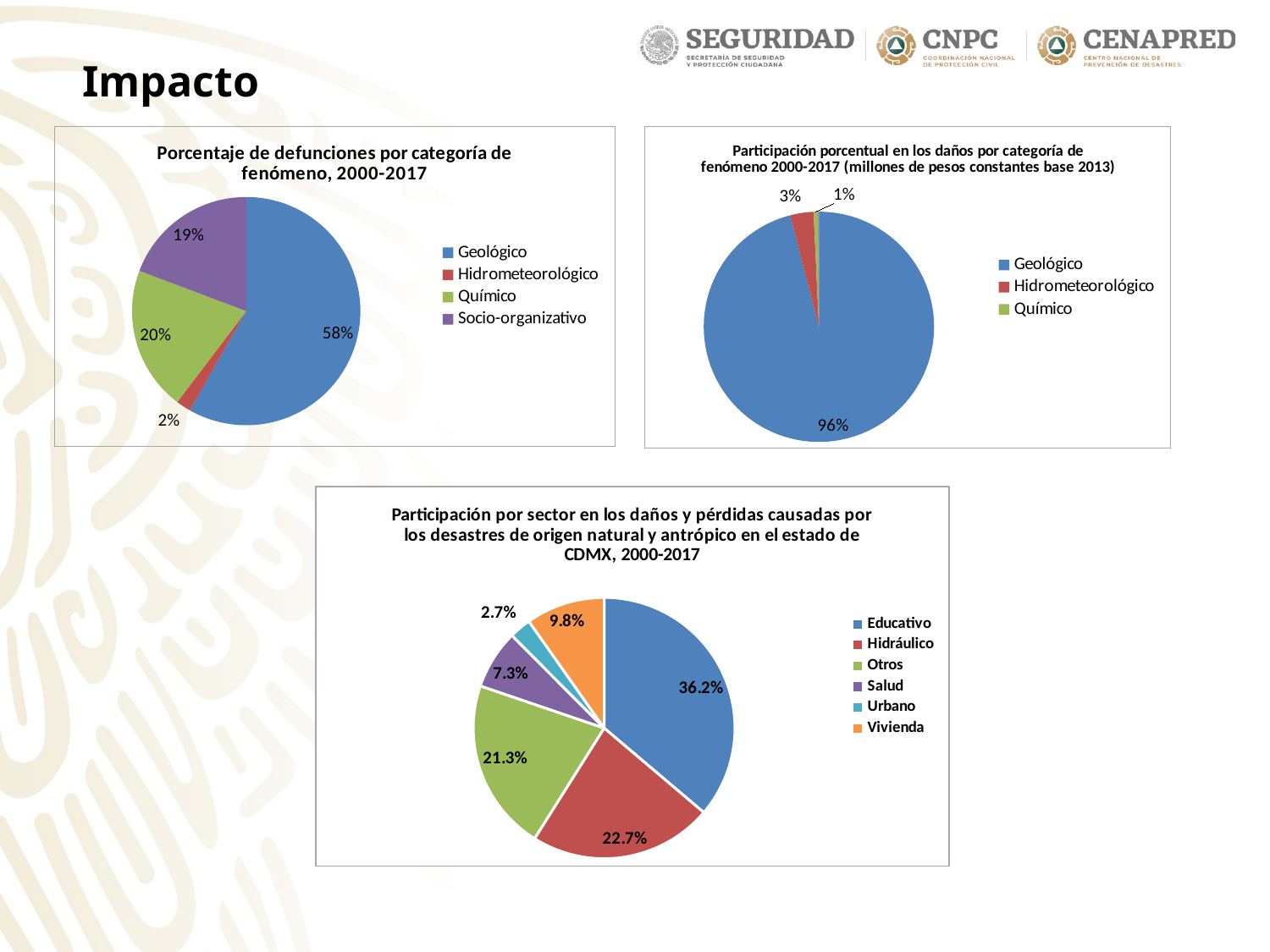
In the top-left chart (Porcentaje de defunciones por categoría de fenómeno, 2000-2017), which category has the smallest share? Hidrometeorológico How many categories does the legend of the top-left chart (Porcentaje de defunciones) list? 4 In the top-right chart (Participación porcentual en los daños por categoría de fenómeno 2000-2017), what share corresponds to Químico? 1% In the bottom chart (Participación por sector en los daños y pérdidas en CDMX, 2000-2017), which sector has the largest share? Educativo In the top-left chart (Porcentaje de defunciones por categoría de fenómeno, 2000-2017), what is the difference in percentage points between Químico and Socio-organizativo? 1 percentage point In the bottom chart (Participación por sector en los daños y pérdidas en CDMX, 2000-2017), what is the difference in percentage points between Vivienda and Salud? 2.5 percentage points In the top-right chart (Participación porcentual en los daños por categoría de fenómeno 2000-2017), what share corresponds to Geológico? 96% In the top-left chart (Porcentaje de defunciones por categoría de fenómeno, 2000-2017), what share of deaths is attributed to Geológico? 58% How many sectors does the legend of the bottom chart (Participación por sector en los daños y pérdidas en CDMX) list? 6 In the top-right chart (Participación porcentual en los daños), which is larger, Hidrometeorológico or Químico? Hidrometeorológico What type of chart is the bottom chart (Participación por sector en los daños y pérdidas causadas por los desastres en CDMX, 2000-2017)? Pie chart In the bottom chart (Participación por sector en los daños y pérdidas en CDMX, 2000-2017), what is the share for Hidráulico? 22.7%